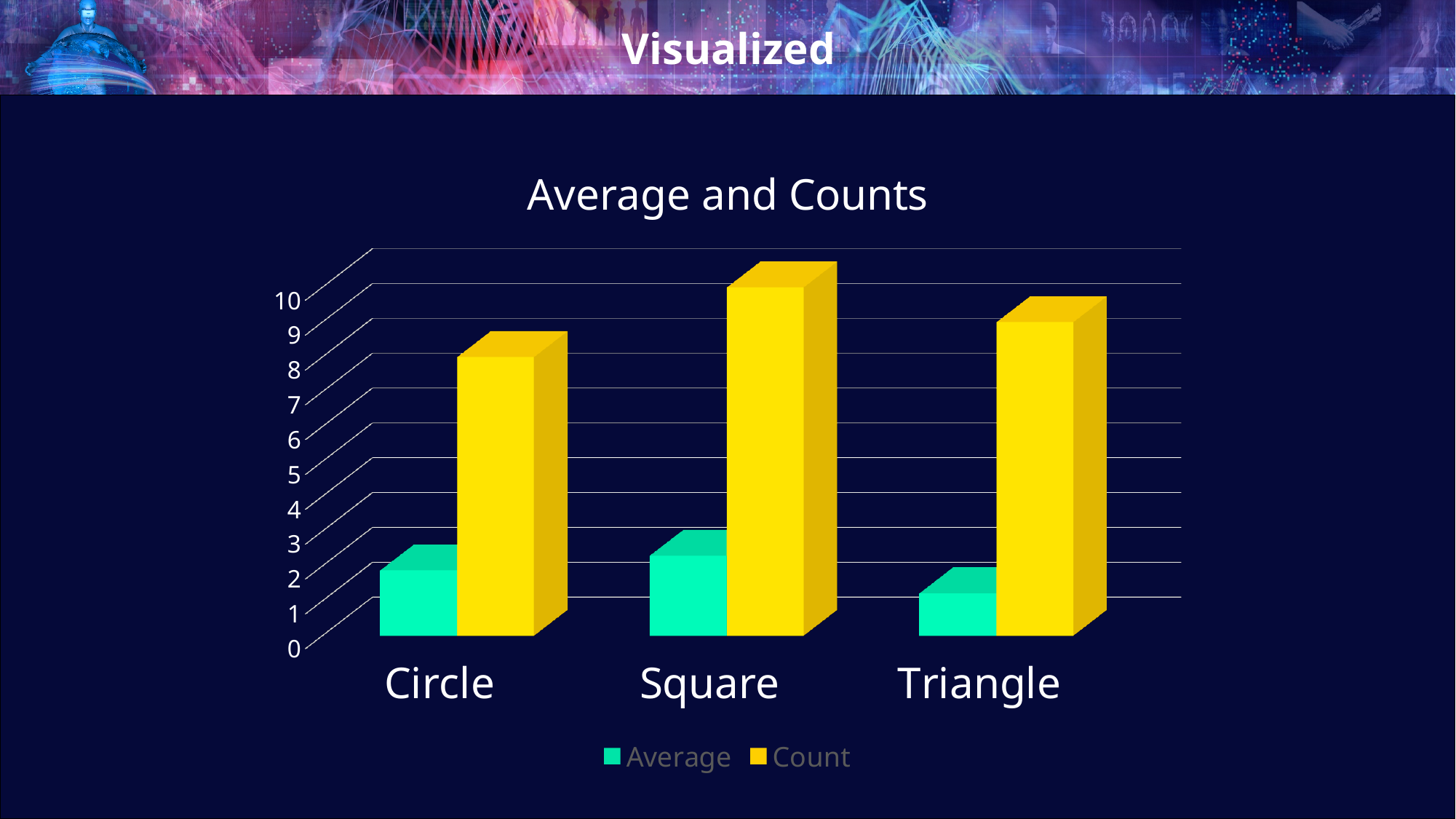
What kind of chart is shown on the slide? bar chart Which series is shown in yellow in the legend? Count Which category has the lowest Count value? Circle What is the title of the chart? Average and Counts How many categories are shown on the x axis? 3 Is the Average value for Triangle greater or less than 3? less For Square, which is larger, the Average or the Count? Count Is the Count value for Triangle greater or less than 6? greater Which category has the lowest Average value? Triangle Is the Count value for Circle greater or less than 5? greater Which category has the highest Count value? Square How many series does the legend list? 2